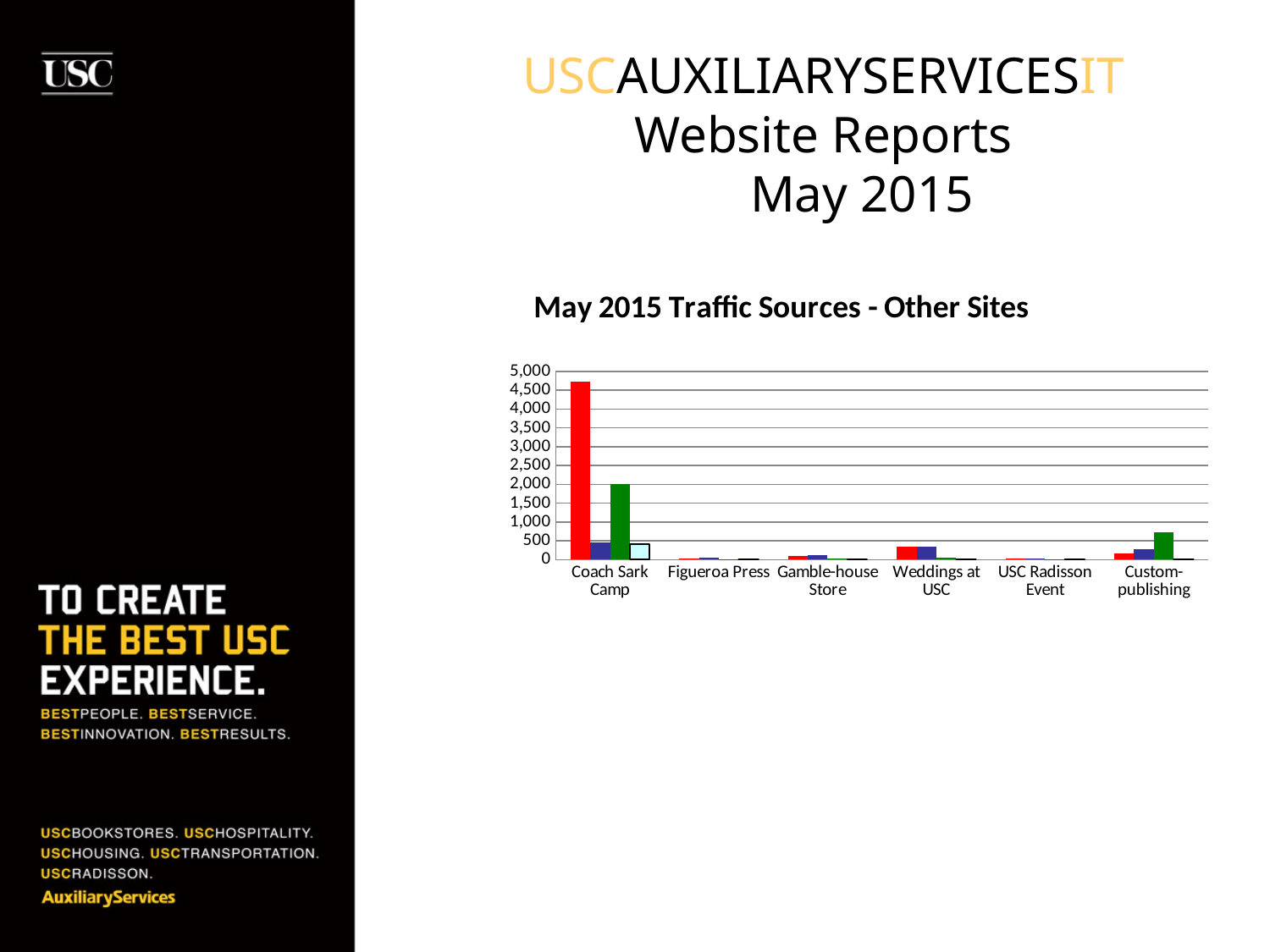
Are all the bars for Figueroa Press greater or less than 500? less What is the highest value shown on the y axis of the chart? 5,000 Which category has the tallest bar in the chart? Coach Sark Camp Is the value of the green bar for Coach Sark Camp greater or less than 1,500? greater Which is larger: the green bar for Coach Sark Camp or the green bar for Custom-publishing? the green bar for Coach Sark Camp How many categories are shown on the x axis of the chart? 6 Is the value of the tallest (red) bar for Coach Sark Camp greater or less than 4,000? greater What is the title of the chart? May 2015 Traffic Sources - Other Sites Which is larger for Coach Sark Camp: the red bar or the green bar? the red bar What kind of chart is shown on the slide? bar chart